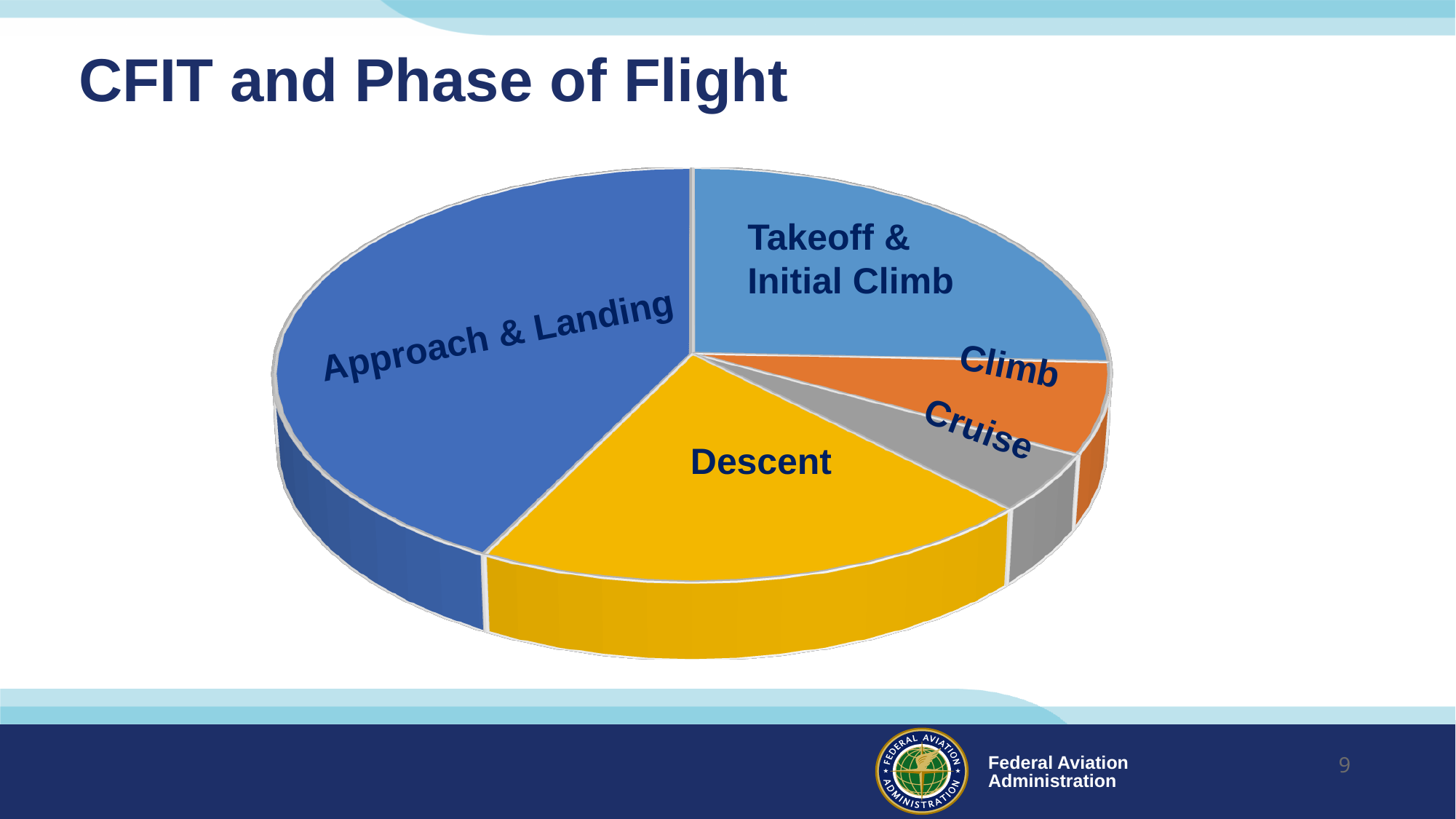
Which slice is larger, Descent or Climb? Descent What kind of chart is shown on the slide? Pie chart Which slice is larger, Approach & Landing or Descent? Approach & Landing Which slice is larger, Takeoff & Initial Climb or Cruise? Takeoff & Initial Climb How many slices does the pie chart have? 5 What is the title of the slide containing the pie chart? CFIT and Phase of Flight Which phase of flight has the largest slice of the pie chart? Approach & Landing What colour is the Descent slice of the pie chart? Yellow